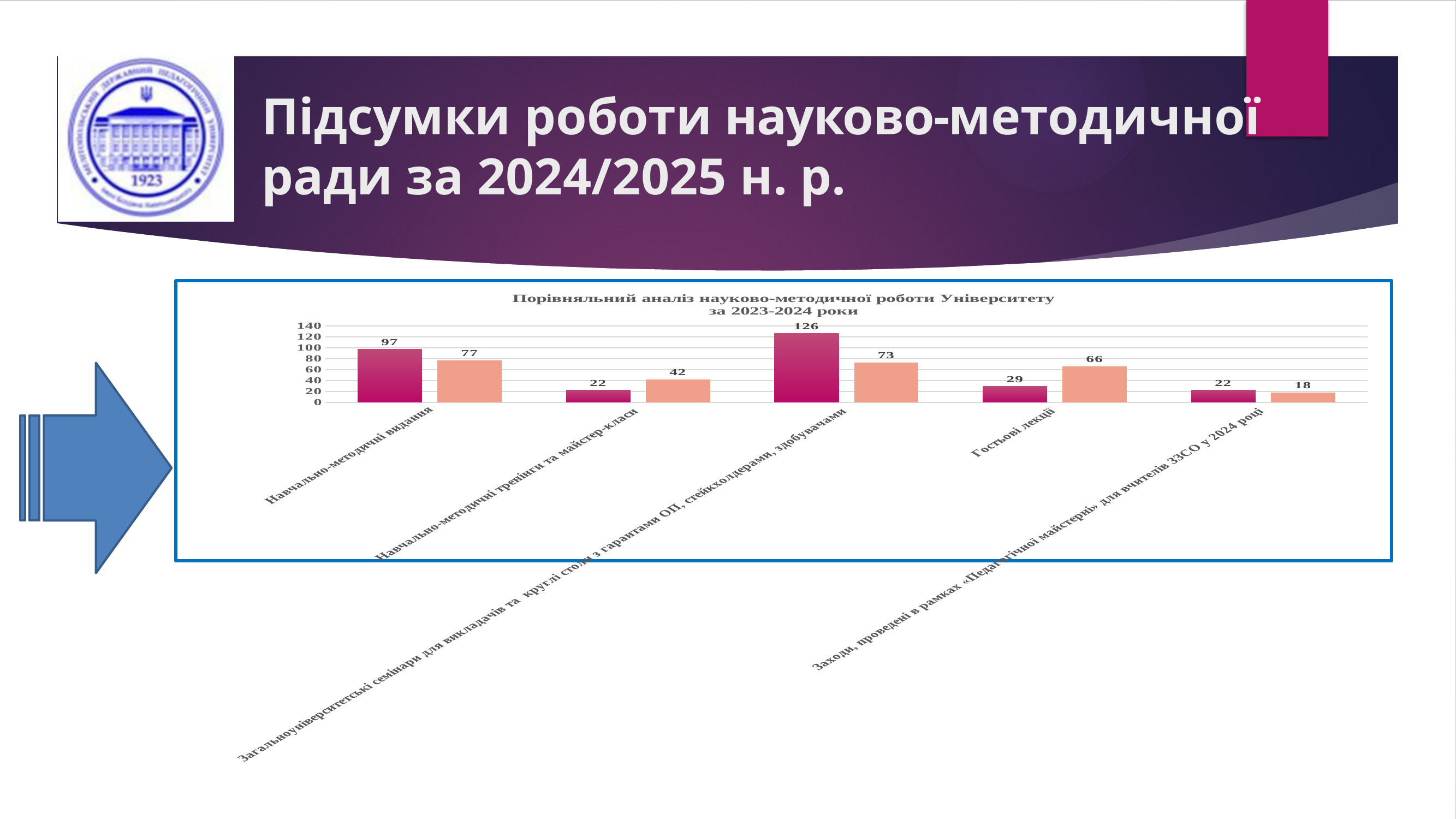
Which category has the lowest light salmon bar? Заходи, проведені в рамках «Педагогічної майстерні» для вчителів ЗЗСО у 2024 році What is the value of the dark magenta bar for "Навчально-методичні видання"? 97 What is the highest value shown on the vertical axis of the chart? 140 For "Гостьові лекції", which bar is larger, the dark magenta one or the light salmon one? the light salmon one What kind of chart is shown on the slide? bar chart What is the difference between the dark magenta bar (126) and the light salmon bar (73) for the "Загальноуніверситетські семінари..." category? 53 What is the value of the dark magenta bar for "Навчально-методичні тренінги та майстер-класи"? 22 What is the value of the light salmon bar for "Гостьові лекції"? 66 What is the title of the chart? Порівняльний аналіз науково-методичної роботи Університету за 2023-2024 роки Which category has the highest dark magenta bar? Загальноуніверситетські семінари для викладачів та круглі столи з гарантами ОП, стейкхолдерами, здобувачами How many categories are shown on the x axis of the chart? 5 What is the value of the light salmon bar for "Навчально-методичні видання"? 77